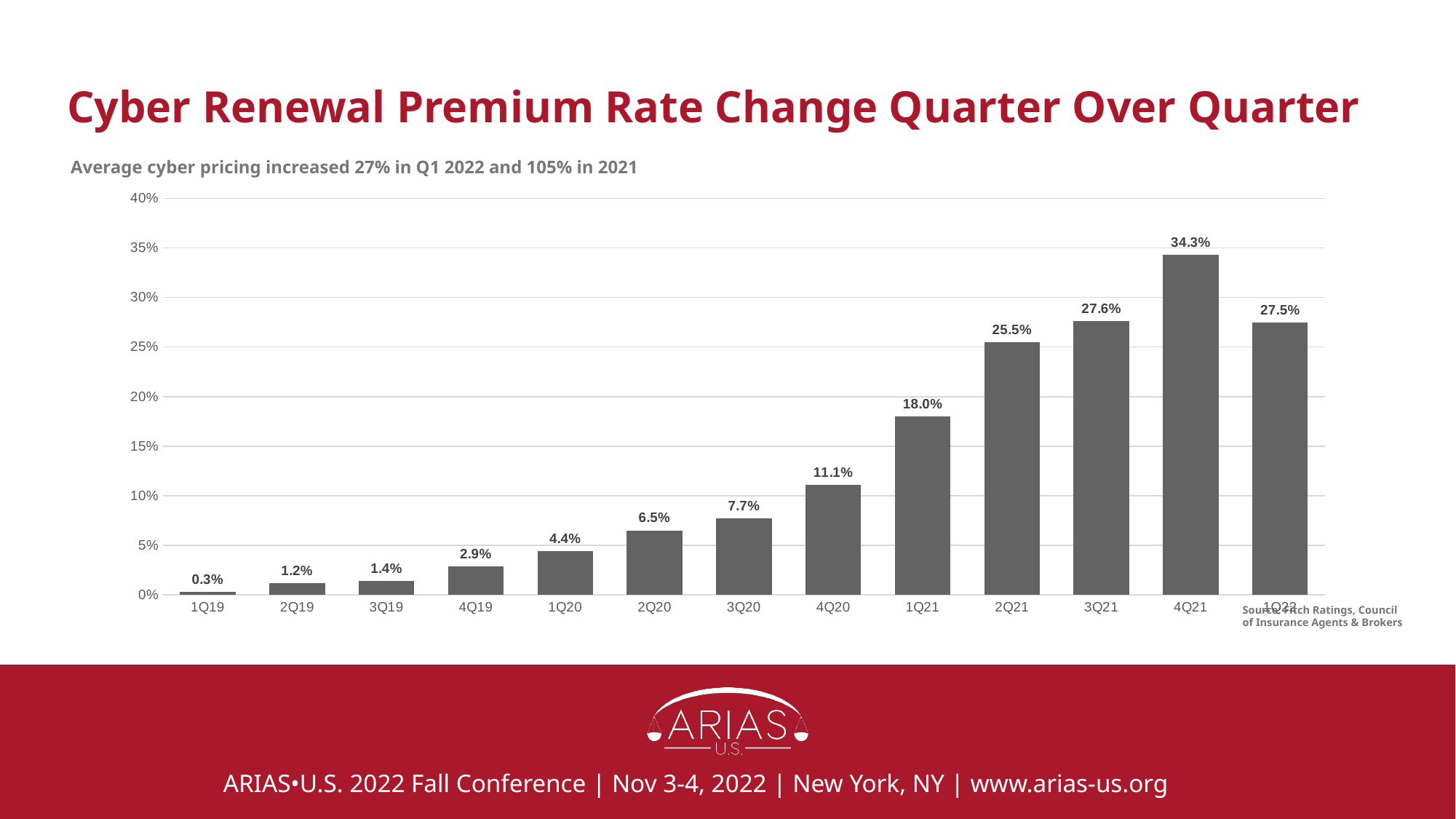
Is the value for 4Q20 greater or less than 10%? greater Which quarter has the highest premium rate change? 4Q21 What is the difference between the values for 1Q21 and 4Q20? 6.9% What is the value shown for 2Q21? 25.5% What is the difference between the values for 4Q21 and 3Q21? 6.7% What is the value shown for 1Q20? 4.4% What kind of chart is shown on the slide? Bar chart Which quarter has the lowest premium rate change? 1Q19 What is the cyber renewal premium rate change for 4Q21? 34.3% Which is larger, the value for 3Q21 or the value for 1Q22? 3Q21 How many quarters are plotted on the chart? 13 Do the values generally rise or fall from 1Q19 to 4Q21? Rise